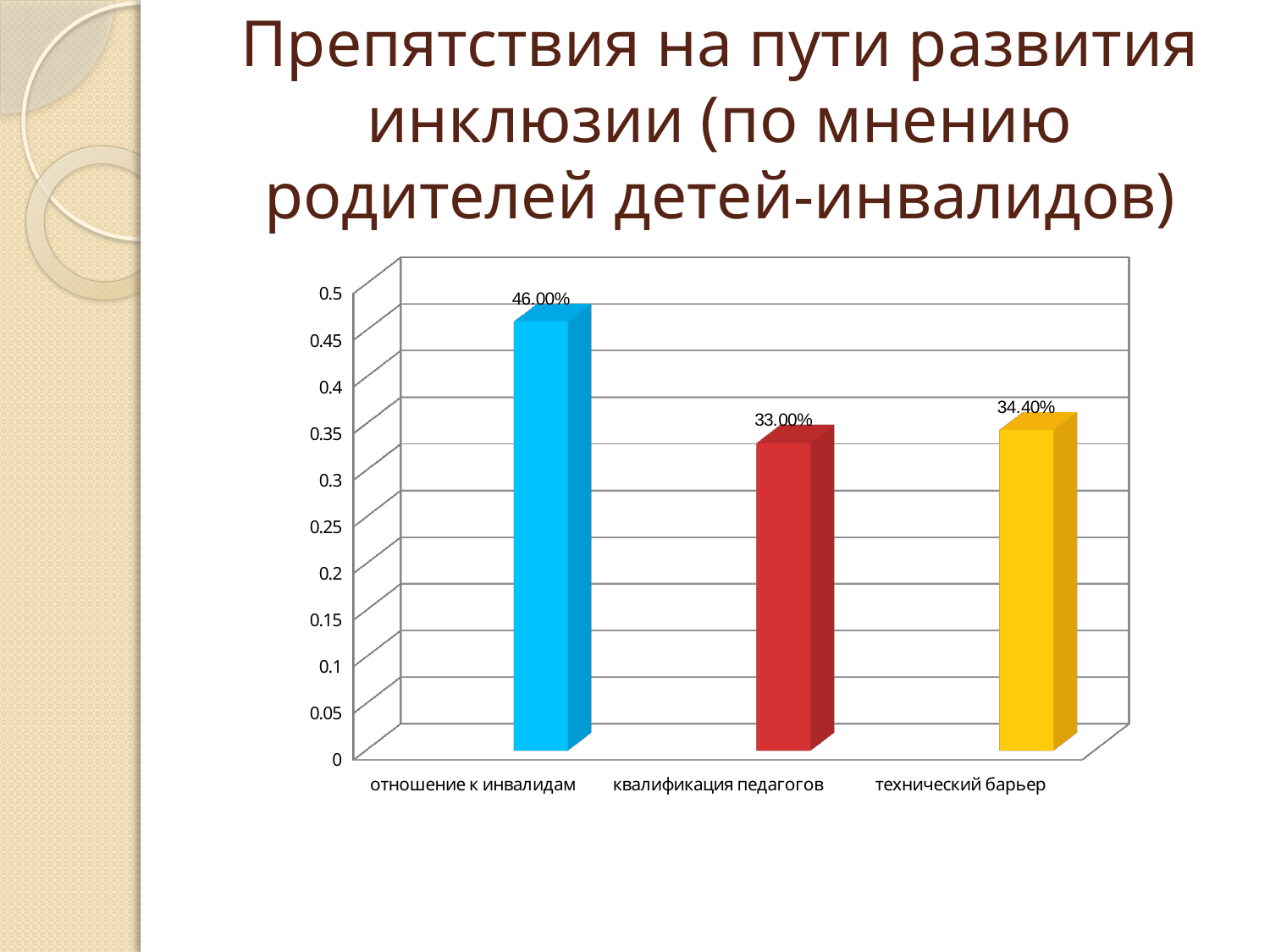
What colour is the bar for "квалификация педагогов"? red What is the difference between the values for "отношение к инвалидам" and "квалификация педагогов"? 13.00% How many categories are shown on the chart? 3 What is the value for "технический барьер"? 34.40% What is the value for "квалификация педагогов"? 33.00% Is the value for "отношение к инвалидам" greater or less than 0.4? greater Which category has the lowest value? квалификация педагогов What is the difference between the values for "технический барьер" and "квалификация педагогов"? 1.40% What is the value for "отношение к инвалидам"? 46.00% Which category has the highest value? отношение к инвалидам Which is larger, the value for "отношение к инвалидам" or the value for "технический барьер"? отношение к инвалидам What kind of chart is shown on the slide? bar chart